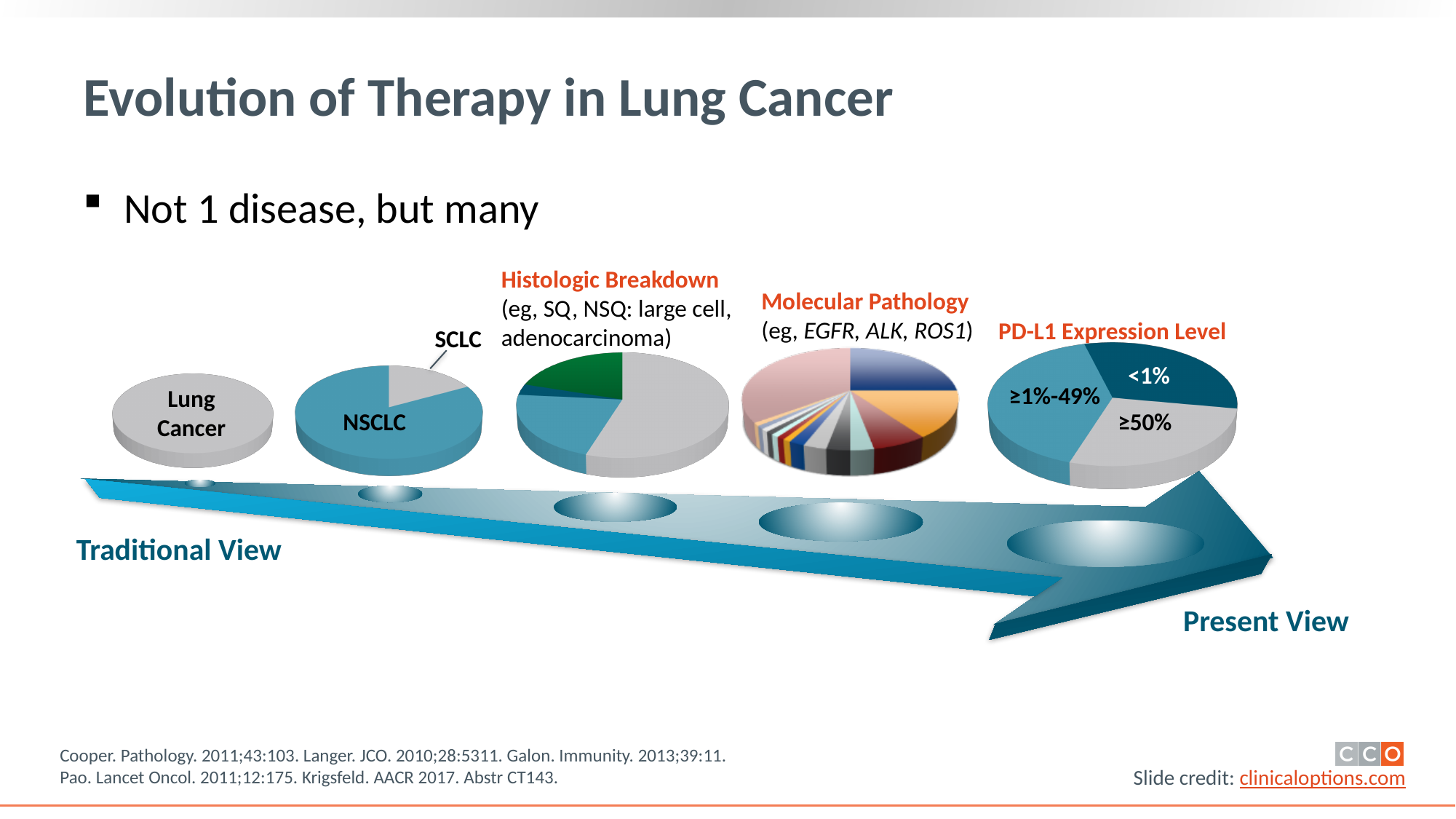
What kind of chart is used for the Molecular Pathology breakdown? pie chart What kind of chart is used to show the NSCLC and SCLC breakdown? pie chart How many categories are shown in the NSCLC/SCLC pie chart? 2 What is the title of the rightmost pie chart on the slide? PD-L1 Expression Level In the NSCLC/SCLC pie chart, which category has the smaller share? SCLC In the NSCLC/SCLC pie chart, which category has the larger share? NSCLC How many categories are shown in the PD-L1 Expression Level pie chart? 3 What are the three category labels in the PD-L1 Expression Level pie chart? <1%, ≥1%-49%, ≥50% How many pie charts are shown along the arrow on the slide? 4 In the NSCLC/SCLC pie chart, is the NSCLC slice larger or smaller than the SCLC slice? larger